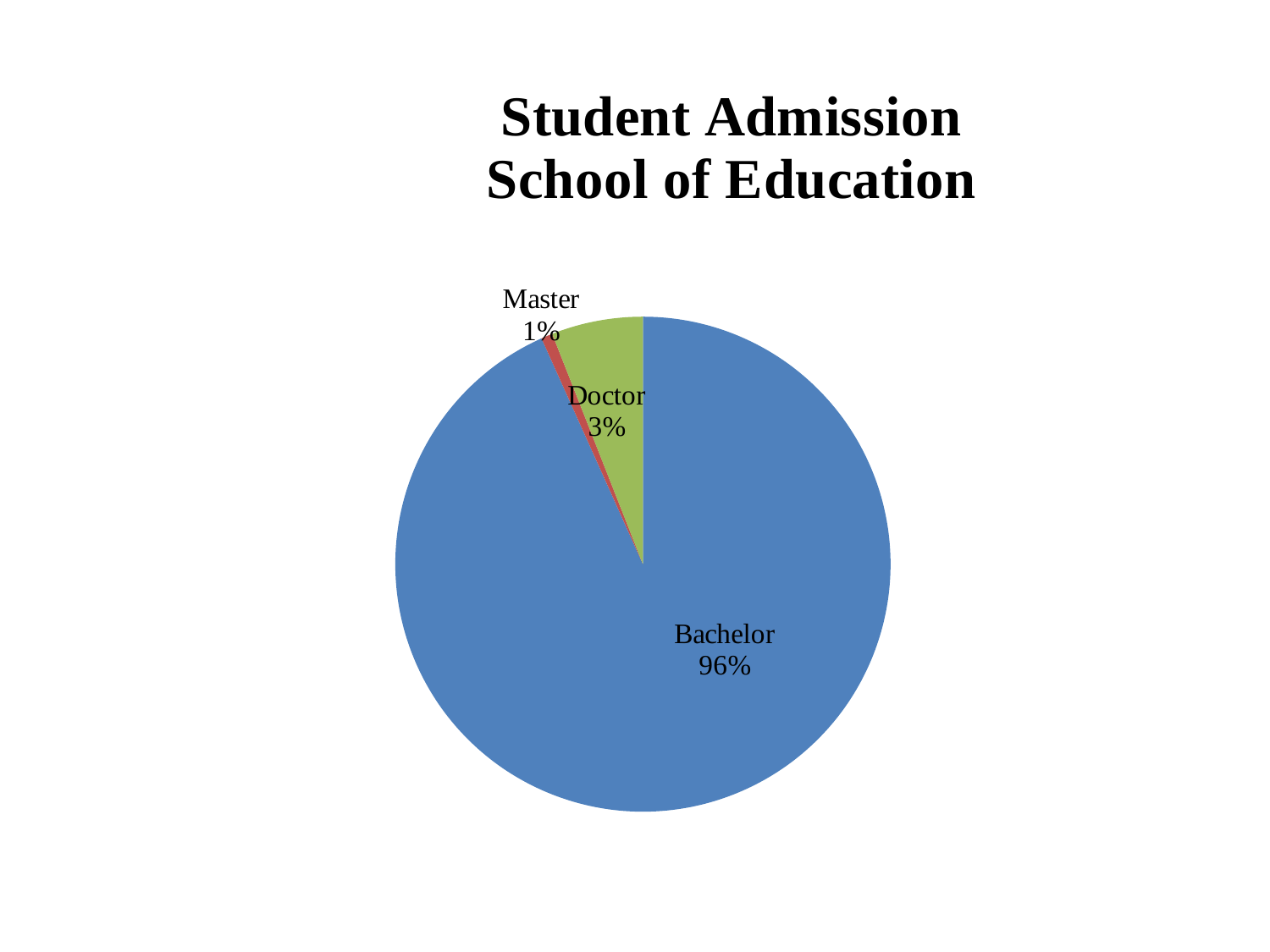
Which category has the smallest share of the pie? Master What is the title of the chart? Student Admission School of Education What is the difference in percentage points between the Doctor and Master shares? 2 What is the difference in percentage points between the Bachelor and Doctor shares? 93 Which is larger, the Doctor share or the Master share? Doctor How many categories are shown in the pie chart? 3 What share of student admissions is Master? 1% What colour is the Bachelor slice? Blue What kind of chart is shown on the slide? Pie chart What share of student admissions is Bachelor? 96% Which category has the largest share of the pie? Bachelor What share of student admissions is Doctor? 3%